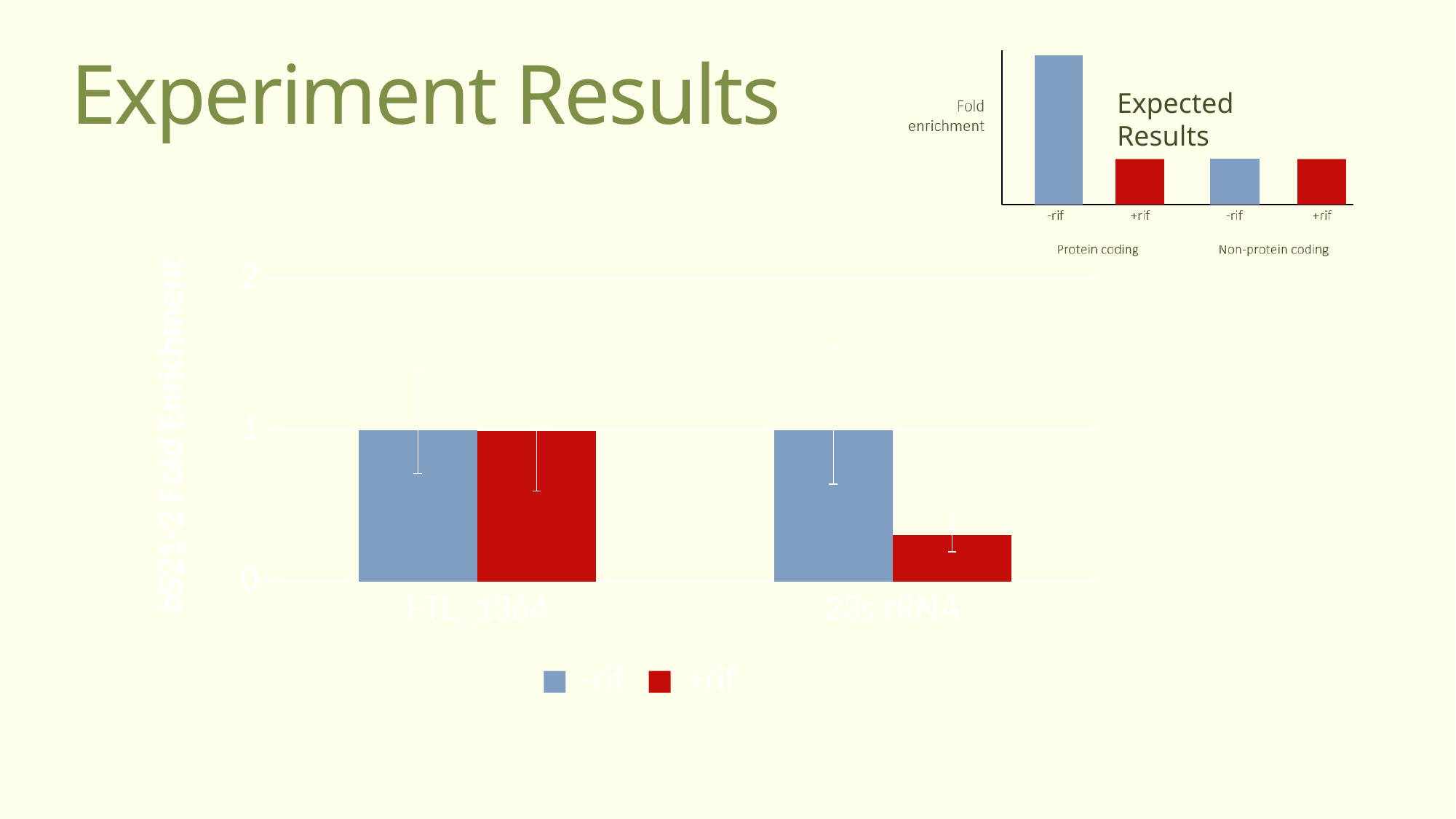
What kind of chart is the main chart with the y-axis 'bS21-2 Fold Enrichment'? bar chart In the main 'bS21-2 Fold Enrichment' chart, what are the two legend entries? -rif and +rif In the main 'bS21-2 Fold Enrichment' chart, which bar is the lowest? +rif for 23s rRNA In the main 'bS21-2 Fold Enrichment' chart, how many categories are shown on the x axis? 2 In the main chart, what is the y-axis title? bS21-2 Fold Enrichment In the main 'bS21-2 Fold Enrichment' chart, how many series does the legend list? 2 In the 'Expected Results' chart at the top right, which bar is the tallest? -rif for Protein coding In the main 'bS21-2 Fold Enrichment' chart, what is the -rif value for FTL_1364? 1 In the main 'bS21-2 Fold Enrichment' chart, is the +rif value for 23s rRNA greater or less than 1? less In the main 'bS21-2 Fold Enrichment' chart, which is larger for 23s rRNA: the -rif value or the +rif value? -rif In the main 'bS21-2 Fold Enrichment' chart, what is the -rif value for 23s rRNA? 1